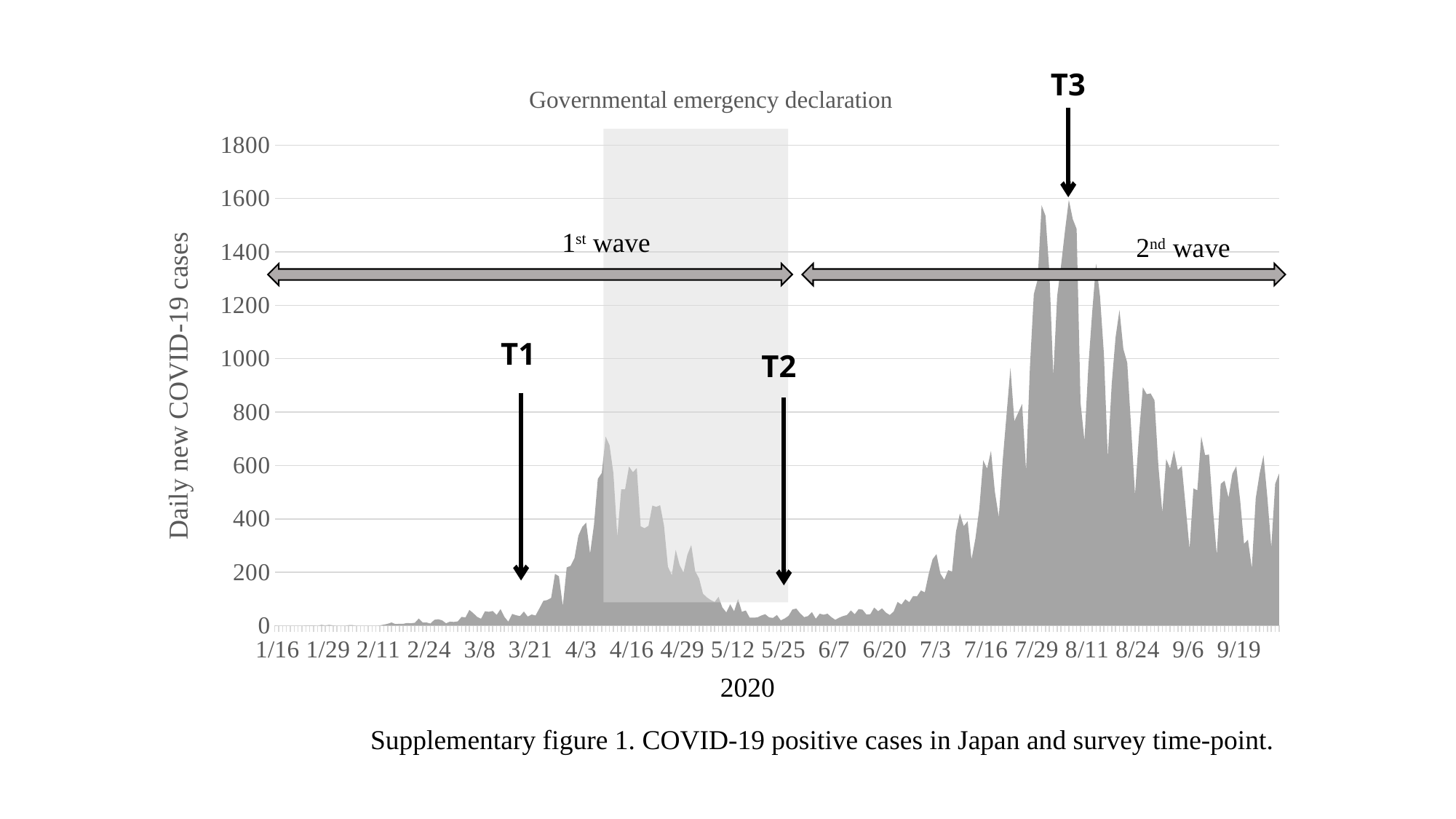
Is the highest peak of daily new cases in the 1st wave greater or less than 800? less What does the shaded grey region in the chart represent, according to its label? Governmental emergency declaration Which wave, the 1st wave or the 2nd wave, reaches the higher peak of daily new cases? 2nd wave Do daily new cases rise or fall between 6/20 and 7/29? rise Is the highest peak of daily new cases in the 2nd wave greater or less than 1400? greater What kind of chart is shown on the slide? Area chart What is the label on the vertical axis of the chart? Daily new COVID-19 cases Is the value of daily new cases at the T1 survey time-point greater or less than 200? less Do daily new cases rise or fall between 4/16 and 5/25? fall What is the highest value shown on the vertical axis of the chart? 1800 How many survey time-points (T labels) are marked with arrows on the chart? 3